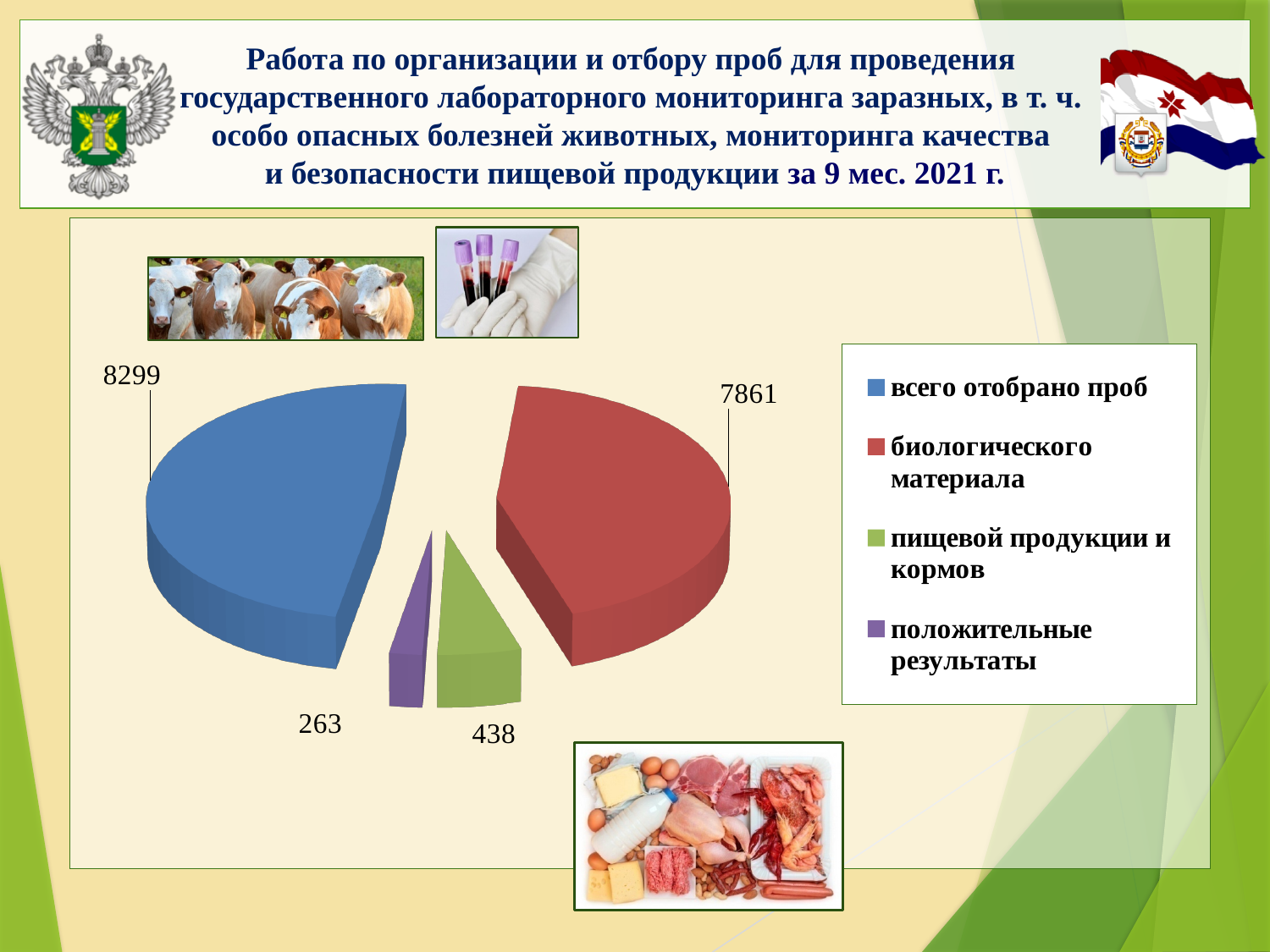
What is the value for "биологического материала"? 7861 Which category has the largest slice in the pie chart? всего отобрано проб What colour is the slice for "биологического материала"? red What is the difference between "всего отобрано проб" and "биологического материала"? 438 What is the value for "положительные результаты"? 263 What is the value for "всего отобрано проб"? 8299 Which is larger: "пищевой продукции и кормов" or "положительные результаты"? пищевой продукции и кормов Which category has the smallest slice in the pie chart? положительные результаты How many categories does the legend of the pie chart list? 4 What is the value for "пищевой продукции и кормов"? 438 What is the difference between "пищевой продукции и кормов" and "положительные результаты"? 175 What type of chart is shown on the slide? pie chart